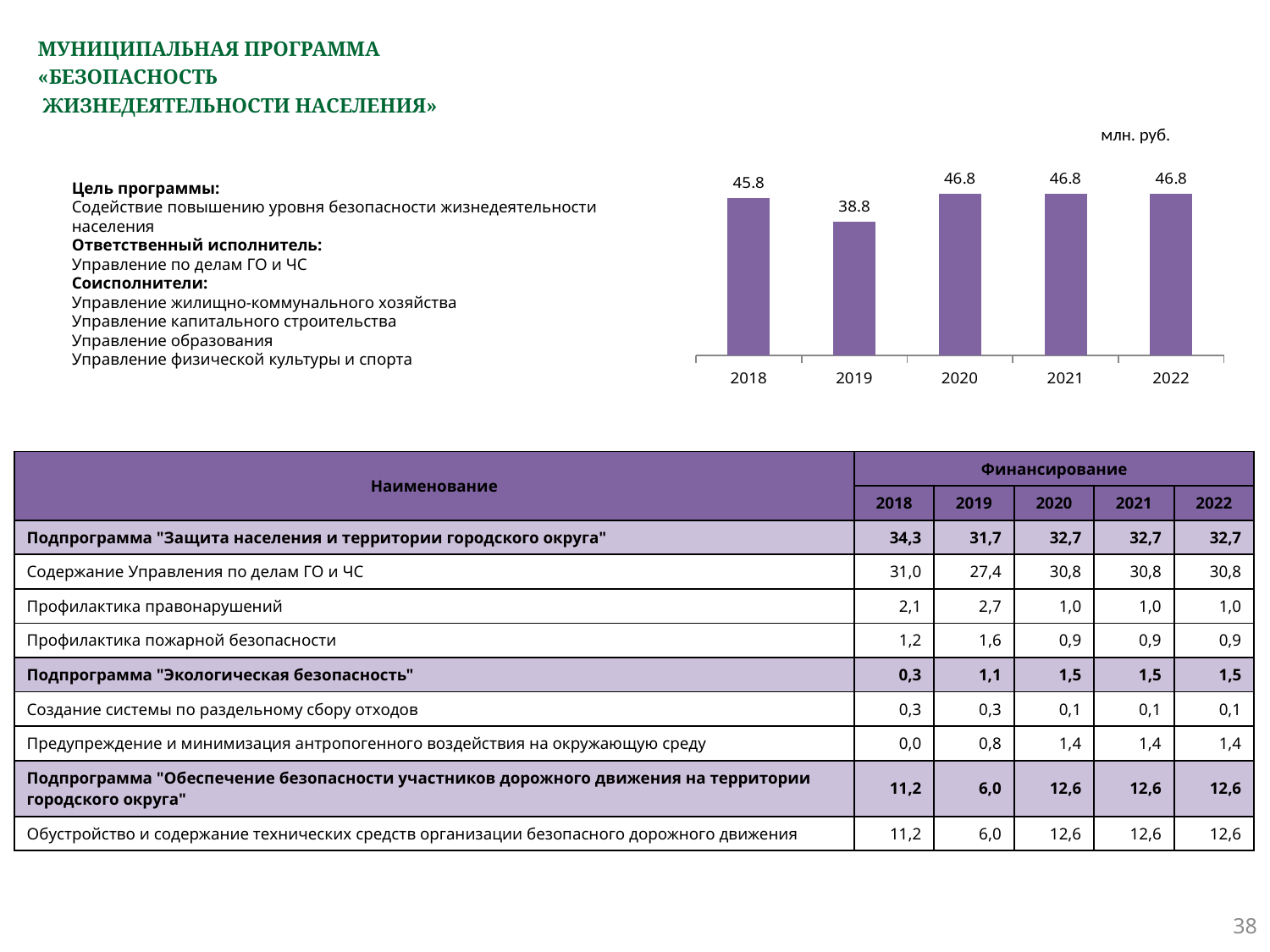
What kind of chart is shown on the slide? bar chart Which is larger on the bar chart, the value for 2019 or the value for 2021? 2021 How many years are shown on the bar chart? 5 What is the value for 2019 on the bar chart? 38.8 What is the value for 2018 on the bar chart? 45.8 Which is larger on the bar chart, the value for 2018 or the value for 2019? 2018 Which year has the lowest value on the bar chart? 2019 What is the difference between the values for 2018 and 2019 on the bar chart? 7.0 What unit is indicated above the bar chart? млн. руб. What is the value for 2020 on the bar chart? 46.8 What is the value for 2022 on the bar chart? 46.8 What is the difference between the values for 2020 and 2019 on the bar chart? 8.0